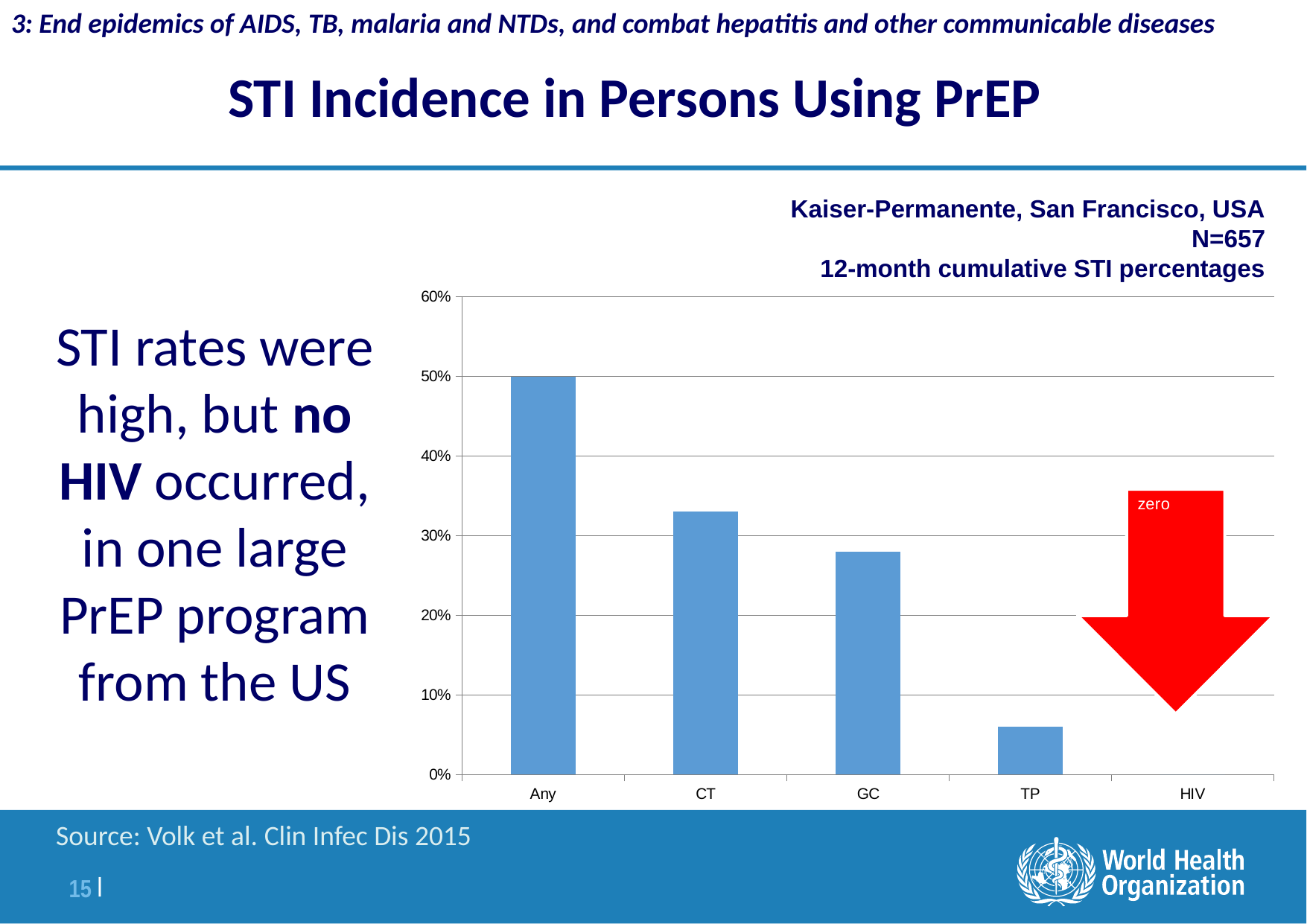
Is the value for GC greater or less than 30%? less Which category has the lowest value in the chart? HIV Which is larger, the value for CT or the value for GC? CT Is the value for TP greater or less than 10%? less Do the bar values rise or fall moving from left to right along the x axis? fall What sample size (N) is stated above the chart? N=657 What is the 12-month cumulative STI percentage for the 'Any' category? 50% How many categories are shown on the x axis of the chart? 5 Is the value for CT greater or less than 30%? greater What kind of chart is shown on the slide? bar chart What is the value shown for HIV in the chart? zero Which category has the highest 12-month cumulative STI percentage? Any